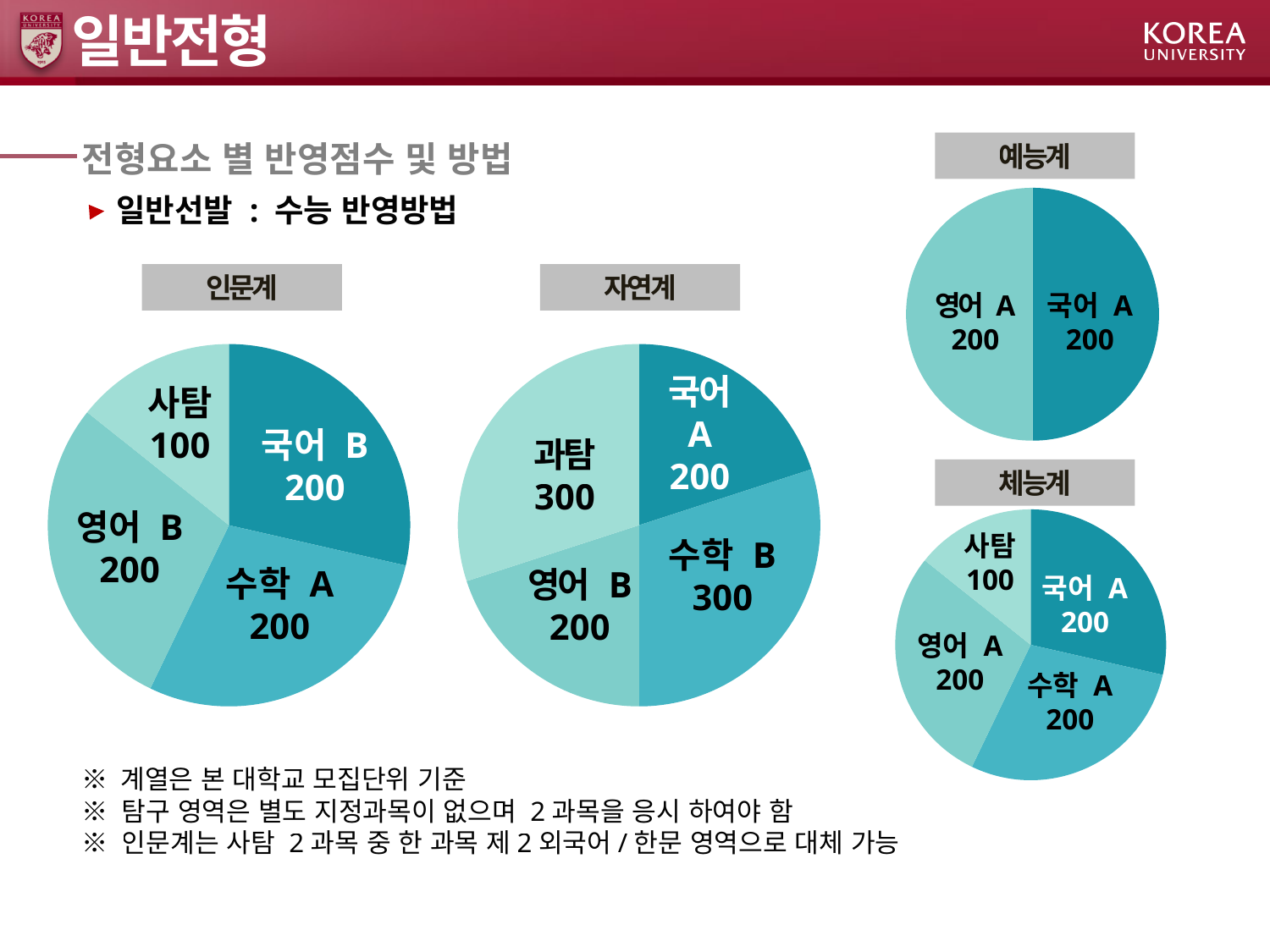
In the 자연계 chart, what is the value for 수학 B? 300 In the 체능계 chart, what is the value for 영어 A? 200 What is the total of all slices in the 자연계 chart? 1000 How many slices does the 체능계 pie chart have? 4 What type of chart is used for 인문계? Pie chart In the 인문계 chart, what is the value for 사탐? 100 How many slices does the 예능계 pie chart have? 2 In the 자연계 chart, what is the difference between 수학 B and 영어 B? 100 In the 자연계 chart, which is larger, 국어 A or 과탐? 과탐 In the 인문계 chart, which category has the lowest value? 사탐 What share of the 예능계 pie does 국어 A represent? 50%